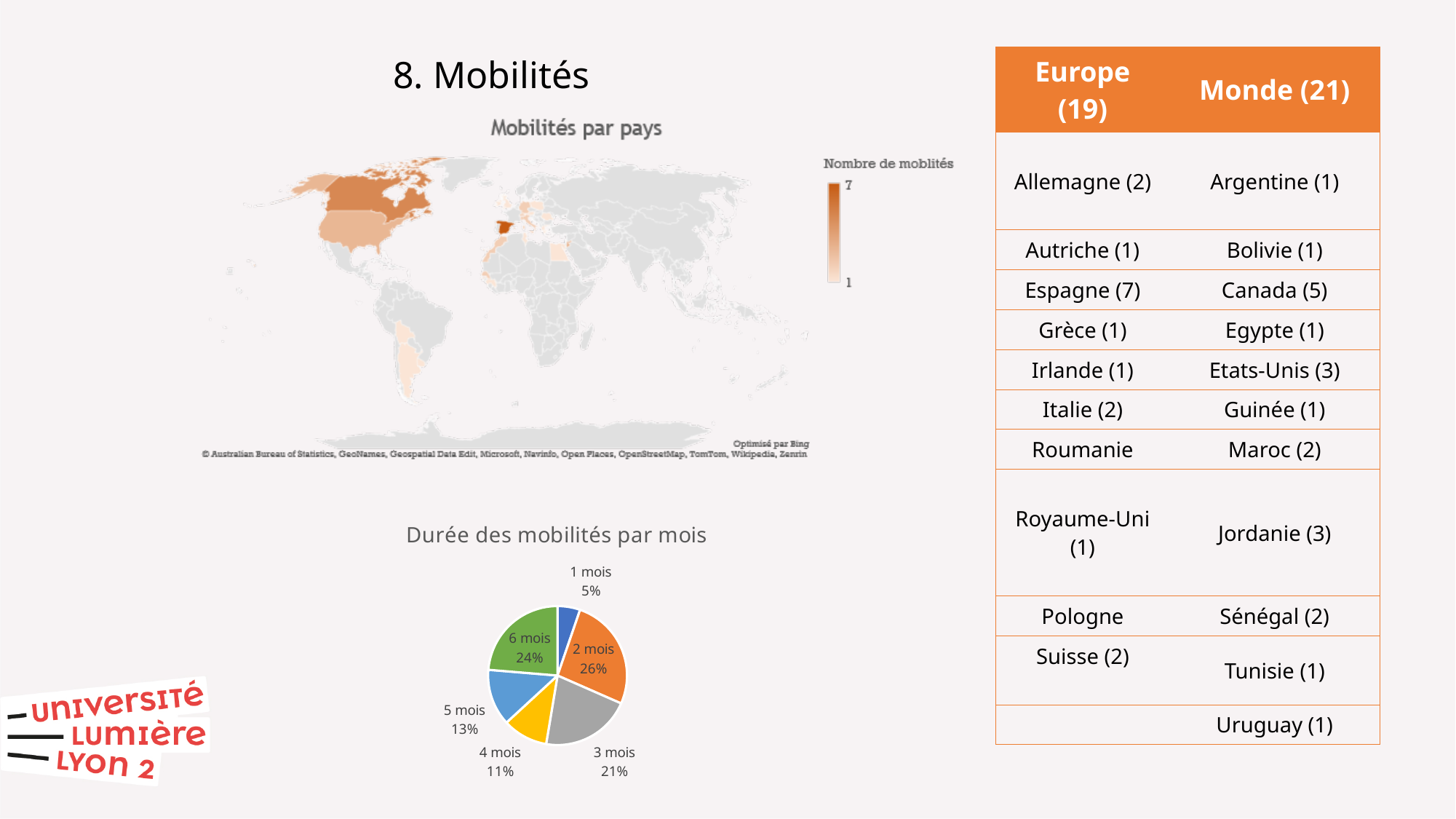
What kind of chart is 'Durée des mobilités par mois'? Pie chart How many slices does the 'Durée des mobilités par mois' chart have? 6 In the 'Durée des mobilités par mois' chart, what is the difference in percentage points between the 3 mois and 5 mois shares? 8 In the 'Durée des mobilités par mois' chart, what share of mobilities lasted 4 mois? 11% In the 'Durée des mobilités par mois' chart, which duration has the smallest share? 1 mois In the 'Durée des mobilités par mois' chart, what colour is the 3 mois slice? Grey In the 'Durée des mobilités par mois' chart, what share of mobilities lasted 2 mois? 26% In the 'Mobilités par pays' chart, what is the maximum value shown on the colour legend 'Nombre de moblités'? 7 In the 'Durée des mobilités par mois' chart, what share of mobilities lasted 6 mois? 24% In the 'Durée des mobilités par mois' chart, which is larger: the share for 5 mois or the share for 4 mois? 5 mois What kind of chart is 'Mobilités par pays'? Map chart In the 'Durée des mobilités par mois' chart, which duration has the largest share? 2 mois